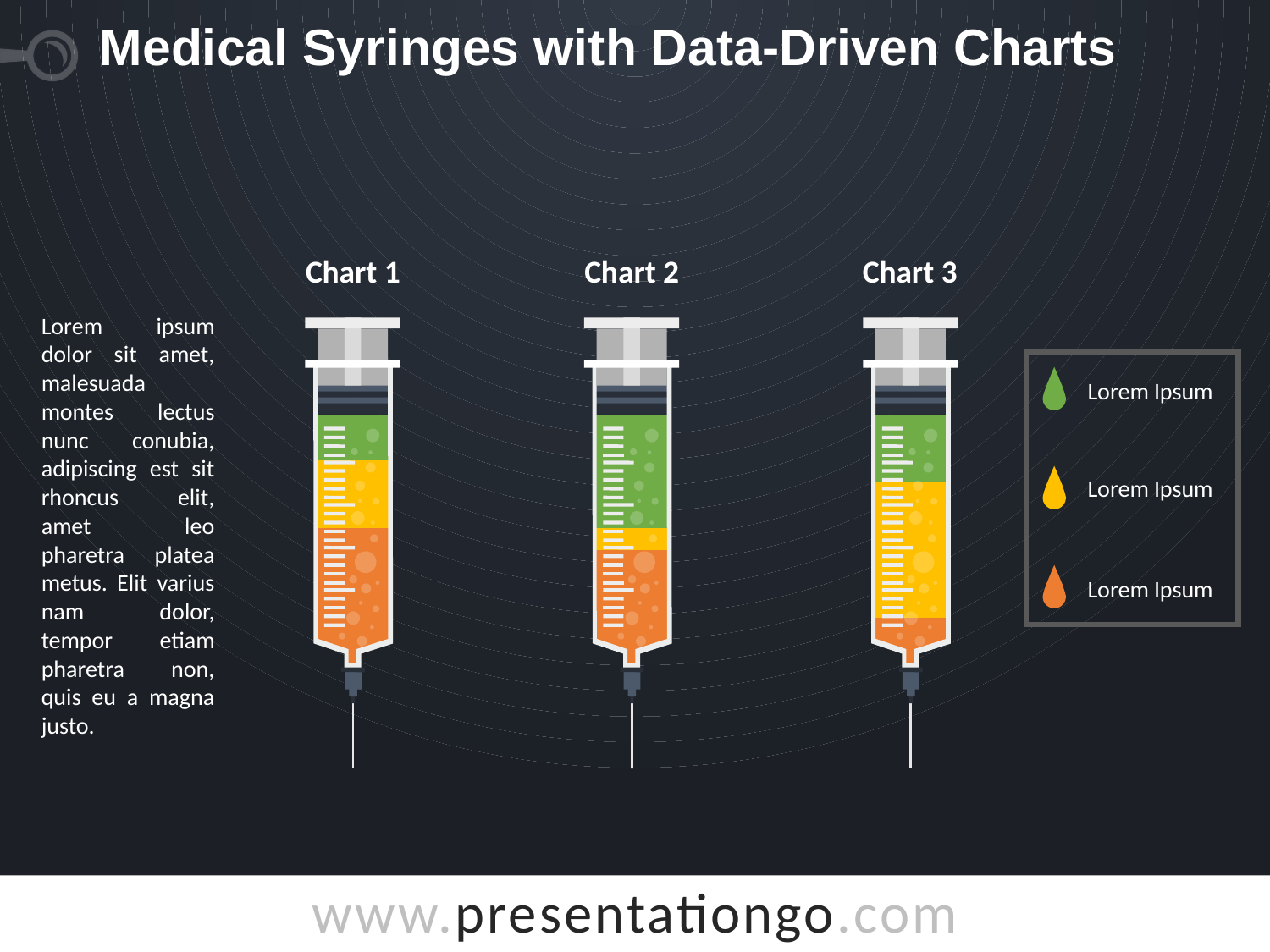
In Chart 1, which colour segment is the largest? Orange In Chart 2, which colour segment is the smallest? Yellow In Chart 2, which colour segment is the largest? Green In Chart 3, which colour segment is the largest? Yellow How many syringe charts are shown on the slide? 3 What are the titles of the three charts, from left to right? Chart 1, Chart 2, Chart 3 Is the green segment larger in Chart 1 or in Chart 2? Chart 2 What kind of chart is used for Chart 1, Chart 2 and Chart 3? Stacked bar chart (syringe-shaped) Is the orange segment larger in Chart 1 or in Chart 3? Chart 1 How many entries does the legend on the right list? 3 In Chart 3, which colour segment is the smallest? Orange What three colours are used for the segments in the charts, from top to bottom? Green, yellow, orange